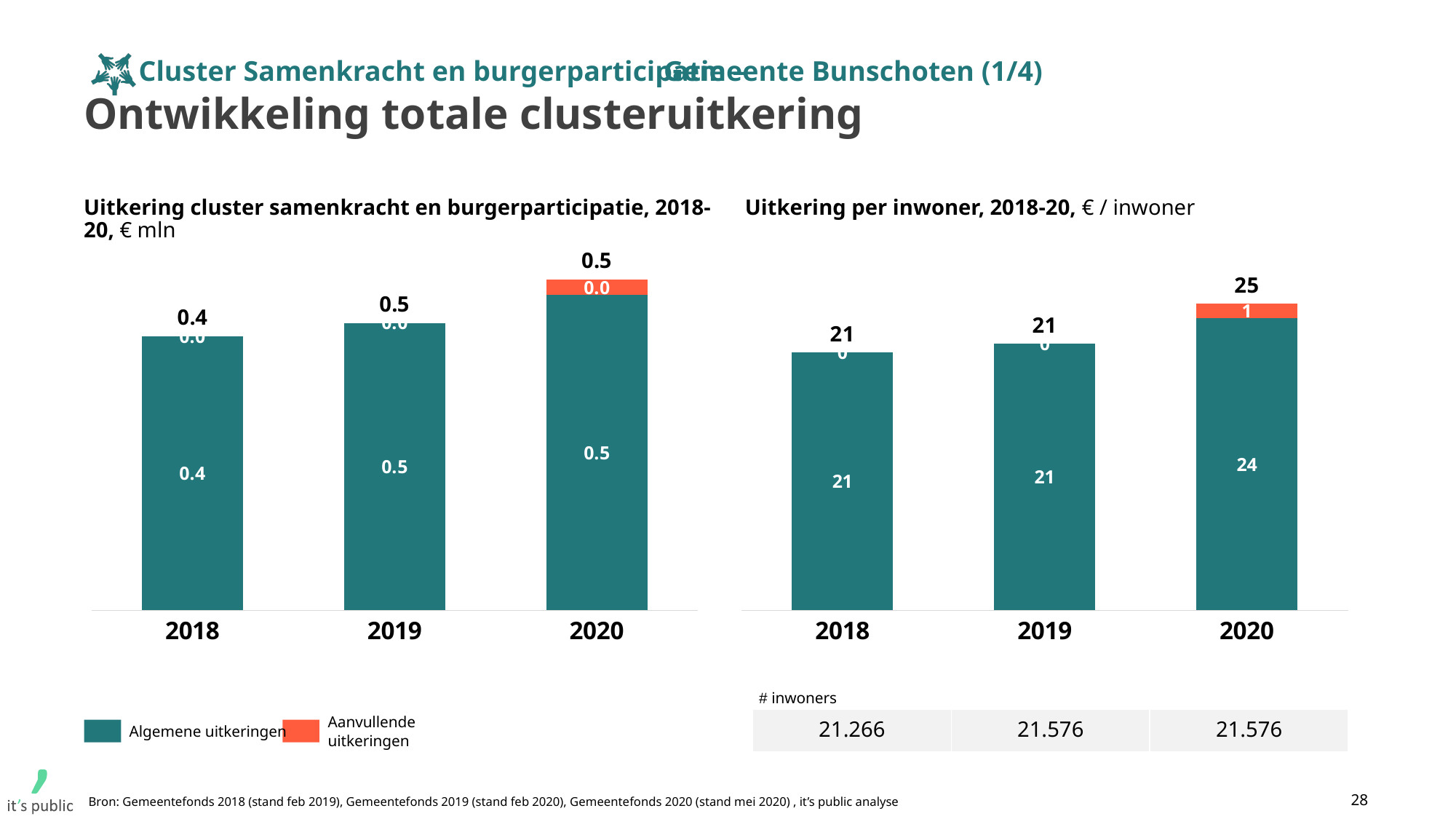
In the right chart (Uitkering per inwoner), is the Algemene uitkeringen value for 2020 larger or smaller than for 2019? larger What kind of chart is the right chart (Uitkering per inwoner)? Stacked bar chart In the right chart (Uitkering per inwoner), which year has the highest total value? 2020 In the right chart (Uitkering per inwoner), what is the difference between the total for 2020 and the total for 2018? 4 In the left chart (Uitkering cluster samenkracht en burgerparticipatie), what is the Algemene uitkeringen value for 2020? 0.5 In the right chart (Uitkering per inwoner), what is the Aanvullende uitkeringen value for 2020? 1 In the left chart (Uitkering cluster samenkracht en burgerparticipatie), what is the total value shown above the bar for 2018? 0.4 In the left chart (Uitkering cluster samenkracht en burgerparticipatie), which year has the lowest total value? 2018 How many years are shown on the x axis of the left chart (Uitkering cluster samenkracht en burgerparticipatie)? 3 In the right chart (Uitkering per inwoner), what is the total value shown above the bar for 2020? 25 In the right chart (Uitkering per inwoner), what is the Algemene uitkeringen value for 2019? 21 How many series does the legend list for the charts on this slide? 2